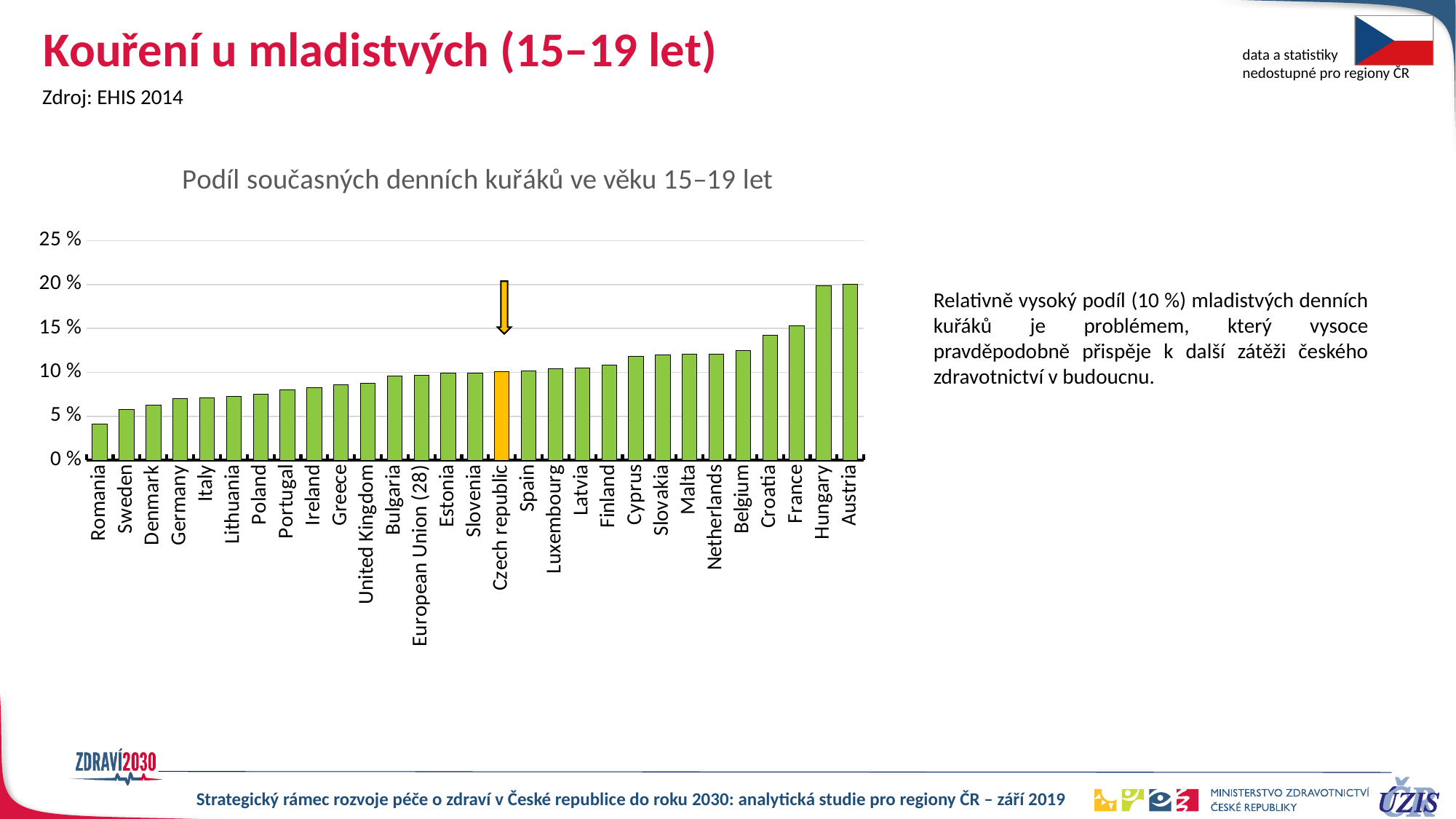
Which has a larger value, Austria or Romania? Austria What kind of chart is shown on the slide? bar chart Is the value for Sweden greater or less than 5 %? greater Is the value for Romania greater or less than 5 %? less Which category's bar is highlighted in orange instead of green? Czech republic Do the values generally rise or fall from left to right along the x axis? rise How many countries/categories are plotted in the chart? 29 Which category has the lowest value in the chart? Romania What is the title of the chart? Podíl současných denních kuřáků ve věku 15–19 let Is the value for Croatia greater or less than 15 %? less